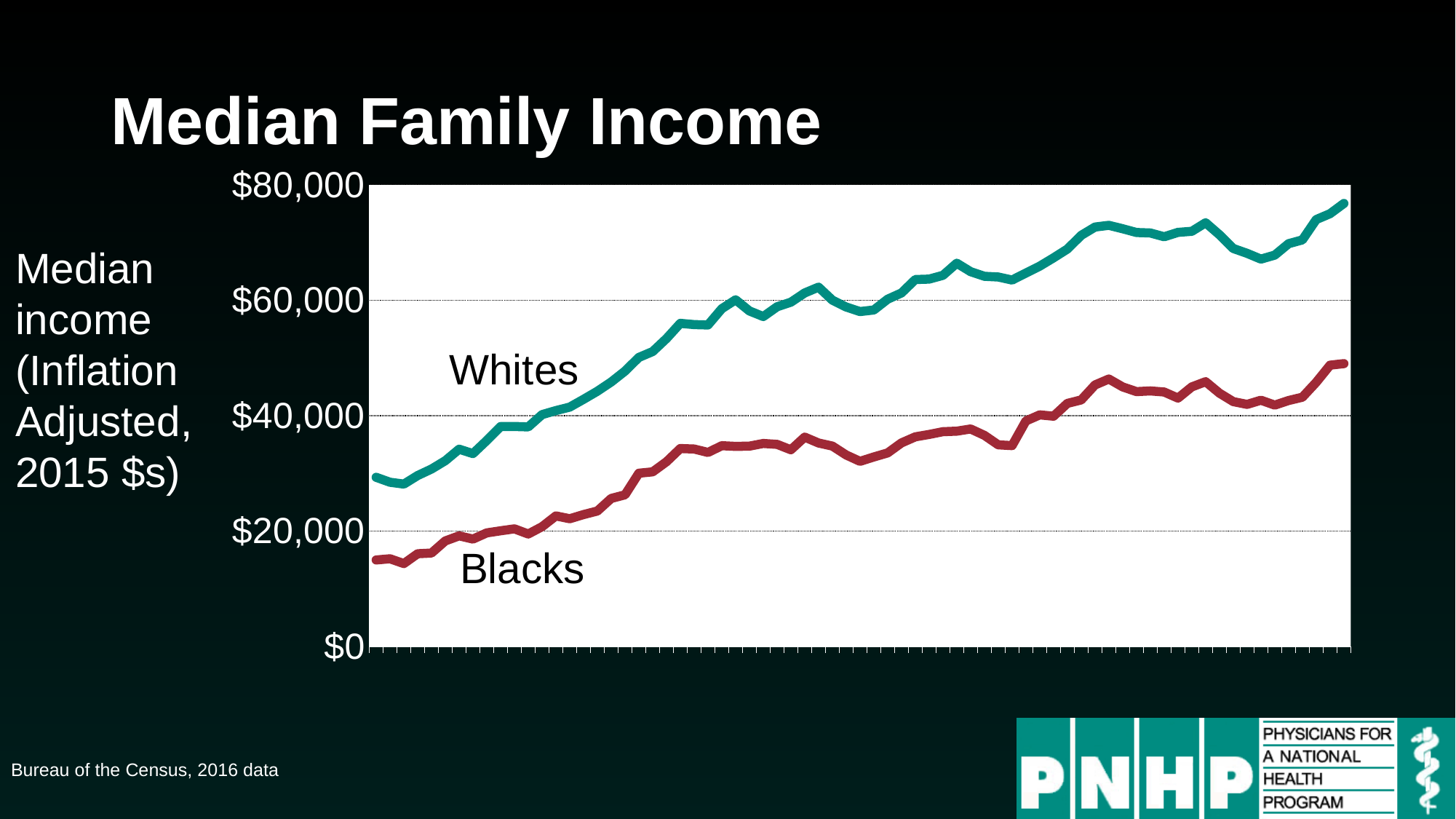
Which series is higher throughout the chart, Whites or Blacks? Whites Does the Whites series generally rise or fall from left to right across the chart? rise Is the value for Blacks at the left end of the chart greater or less than $20,000? less Is the value for Whites at the right end of the chart greater or less than $60,000? greater What is the highest value shown on the vertical axis of the chart? $80,000 What is the title of the chart on the slide? Median Family Income Does the Blacks series generally rise or fall from left to right across the chart? rise Is the value for Blacks at the right end of the chart greater or less than $40,000? greater What kind of chart is shown on the slide? line chart How many data series are plotted on the chart? 2